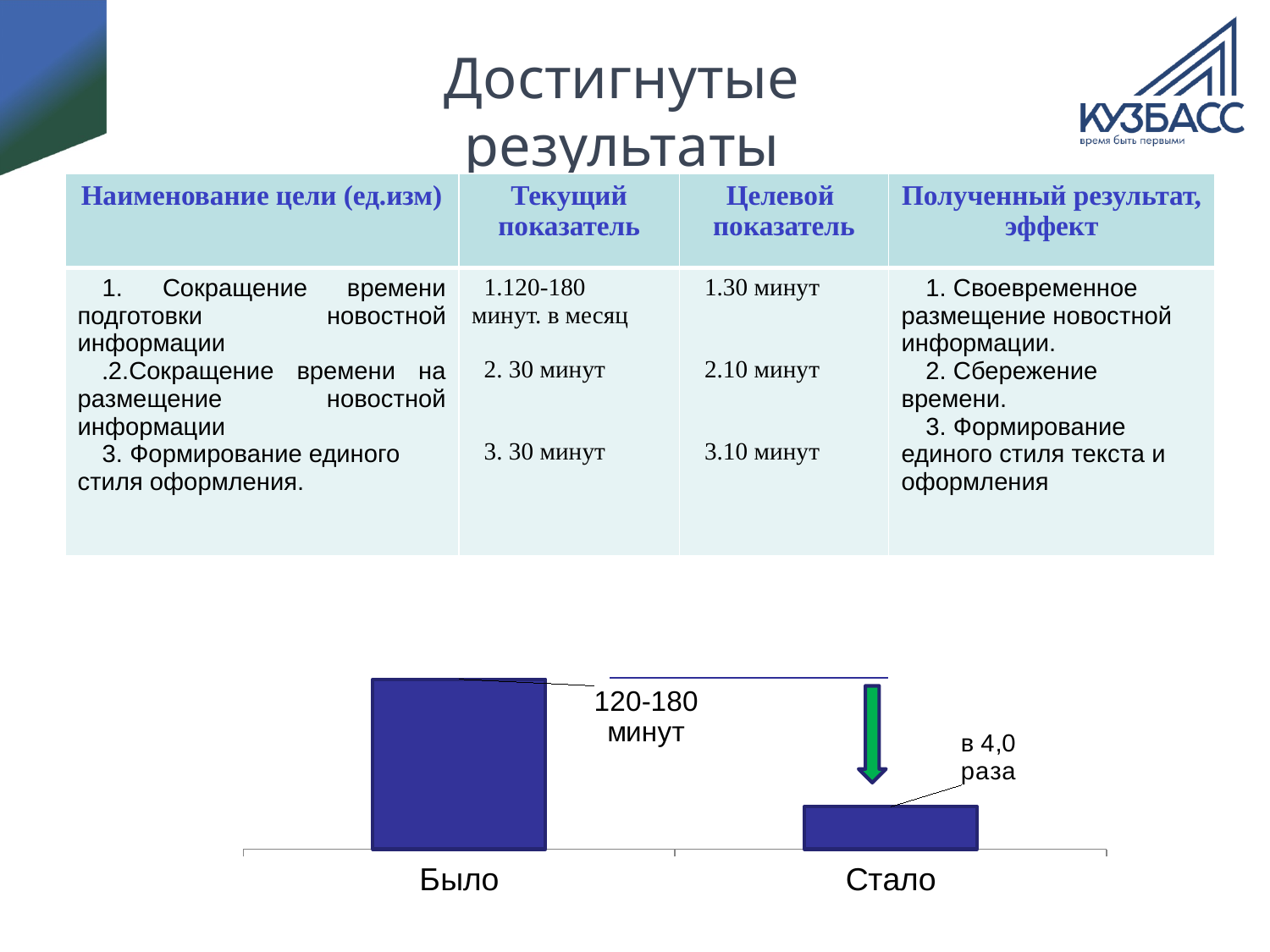
How many categories are shown on the x axis of the bar chart? 2 What annotation is attached to the Стало bar in the chart? в 4,0 раза In the bar chart, which bar is taller: Было or Стало? Было What are the two category labels on the x axis of the bar chart? Было, Стало Do the bar values rise or fall from Было to Стало? fall What kind of chart is shown at the bottom of the slide? bar chart Which category in the bar chart has the lowest bar? Стало What value label is attached to the Было bar in the chart? 120-180 минут Which category in the bar chart has the highest bar? Было